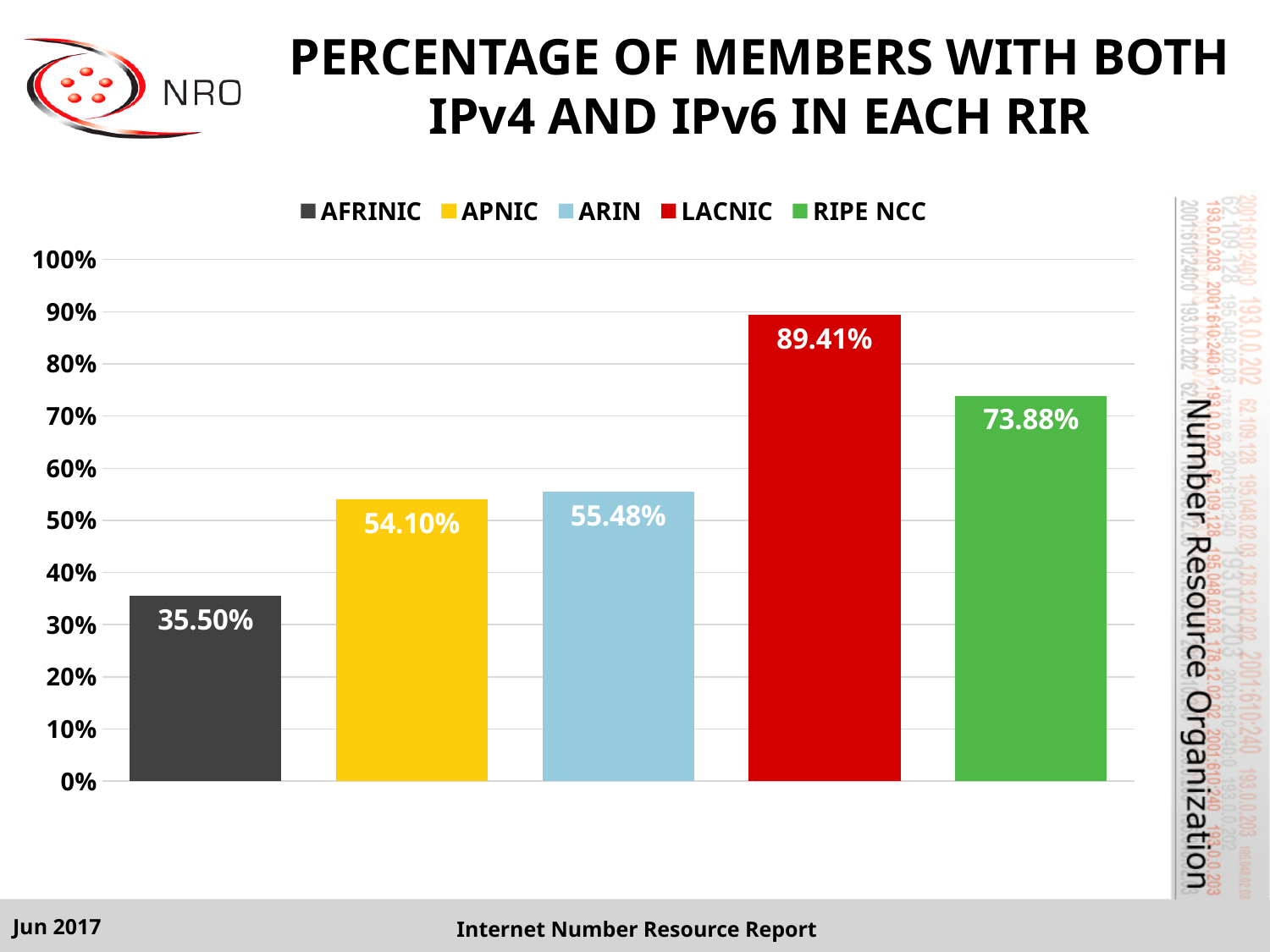
How many RIRs are shown in the chart? 5 What colour is the bar for LACNIC? Red What is the value shown for APNIC? 54.10% What is the difference between the LACNIC and RIPE NCC percentages? 15.53% What kind of chart is shown on the slide? Bar chart What is the difference between the ARIN and AFRINIC percentages? 19.98% What is the percentage of members with both IPv4 and IPv6 for LACNIC? 89.41% Which RIR has the lowest percentage of members with both IPv4 and IPv6? AFRINIC What is the percentage of members with both IPv4 and IPv6 for AFRINIC? 35.50% Which RIR has the highest percentage of members with both IPv4 and IPv6? LACNIC Which has a larger percentage, RIPE NCC or APNIC? RIPE NCC What is the value shown for RIPE NCC? 73.88%